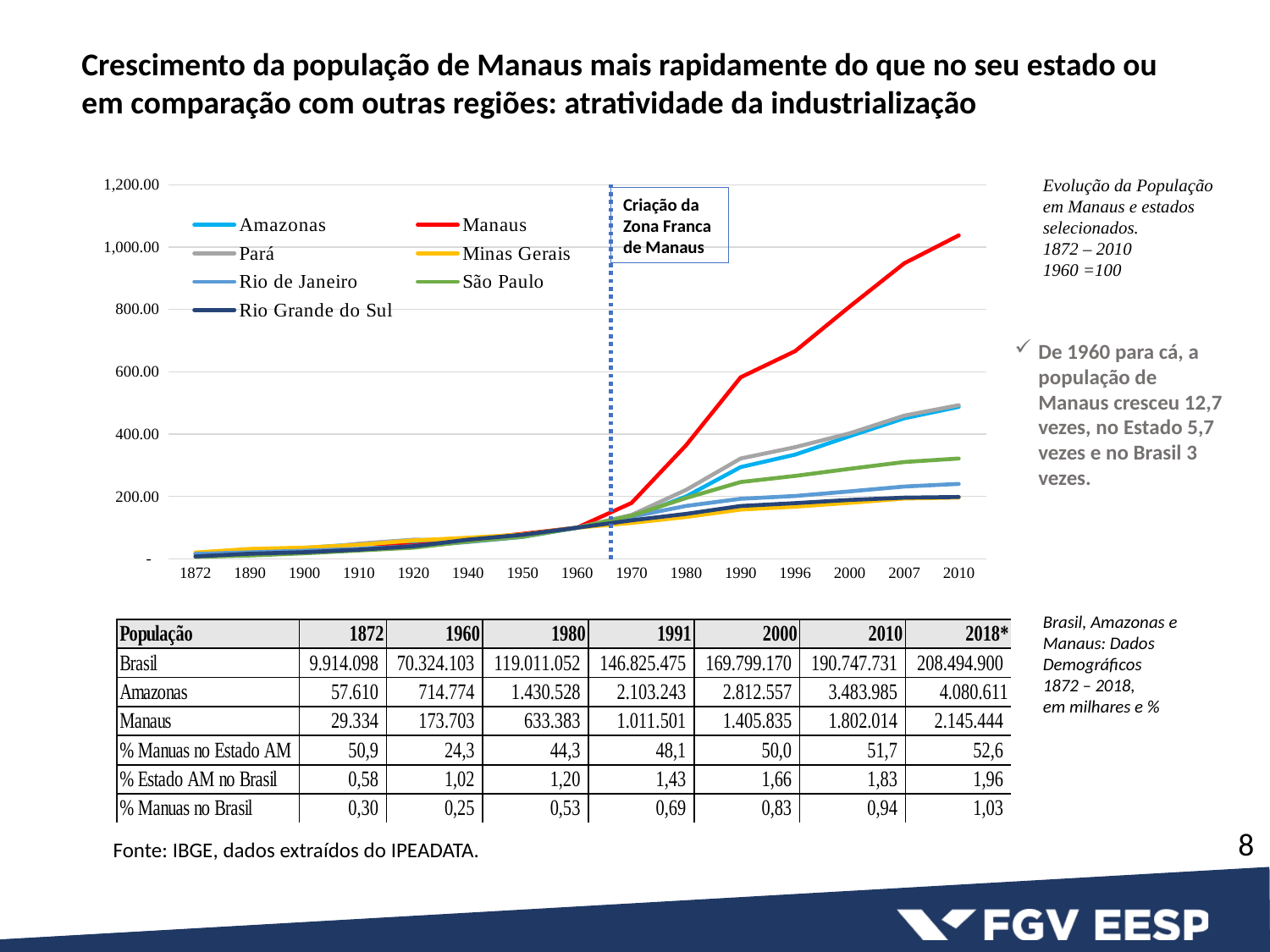
Is the value for Manaus in 1990 greater or less than 400? greater What kind of chart is shown on the slide? line chart Is the value for São Paulo in 2010 greater or less than 400? less What colour is the Manaus line in the chart? red How many years are marked along the x axis of the chart? 15 Which series has the highest value in 2010 on the chart? Manaus Which is larger in 2010, the value for Manaus or the value for São Paulo? Manaus What event does the dashed vertical line on the chart mark? Criação da Zona Franca de Manaus Is the value for Manaus in 2010 greater or less than 800? greater Does the Manaus line rise or fall from 1960 to 2010? rise How many series does the chart legend list? 7